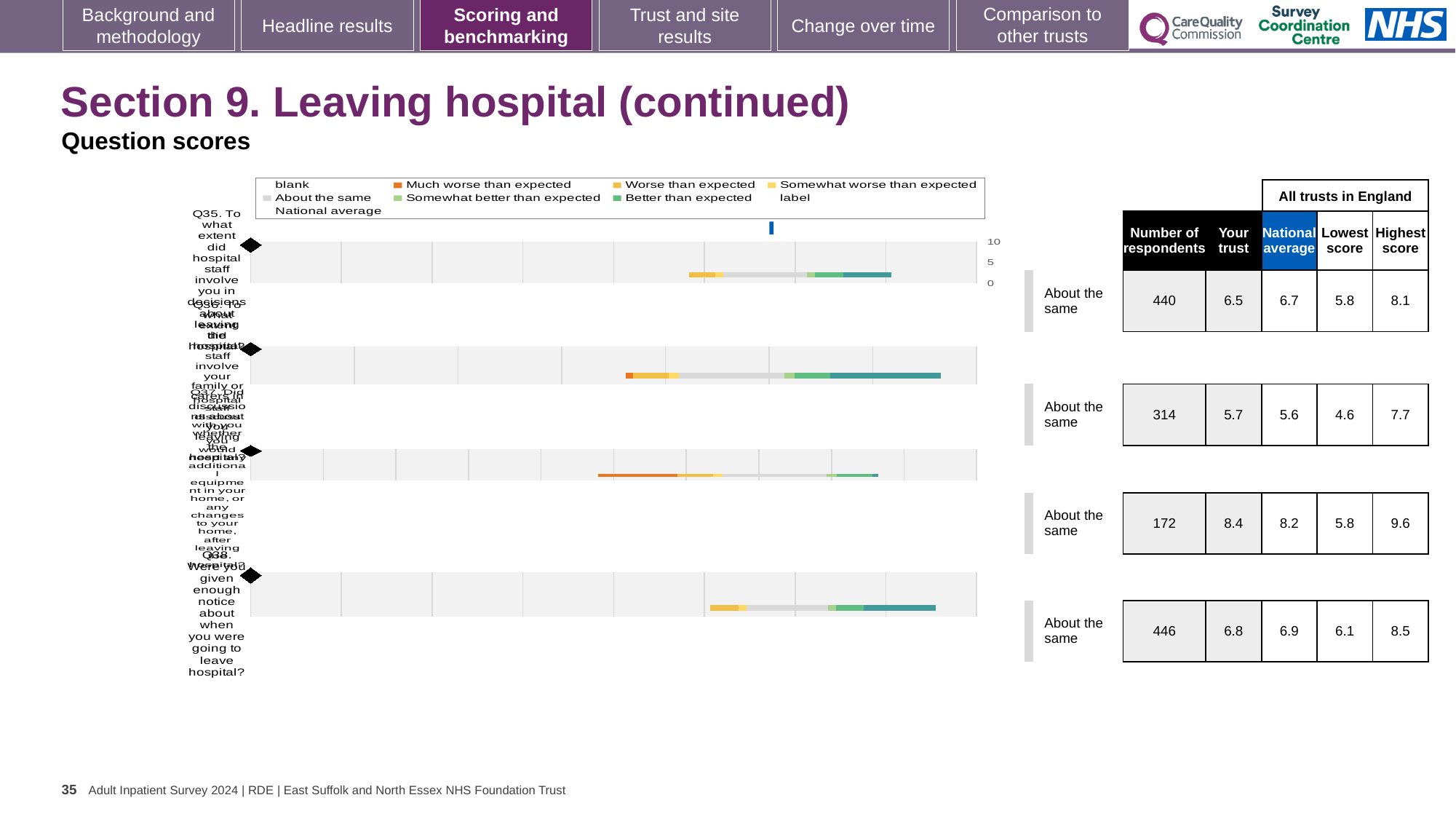
How many question rows are plotted in the chart? 4 For Q38, which is larger: the 'Your trust' score or the national average? National average Which question has the lowest 'Your trust' score? Q36 What benchmark category is shown for Q36? About the same What is the lowest score among all trusts in England for Q36? 4.6 What is the national average score for Q37? 8.2 How many respondents are shown for Q38? 446 What kind of chart is shown on the slide? bar chart What is the 'Your trust' score for Q35? 6.5 Which question has the highest 'Your trust' score? Q37 For Q35, what is the difference between the highest score and the lowest score among all trusts in England? 2.3 How many entries does the chart legend list? 9